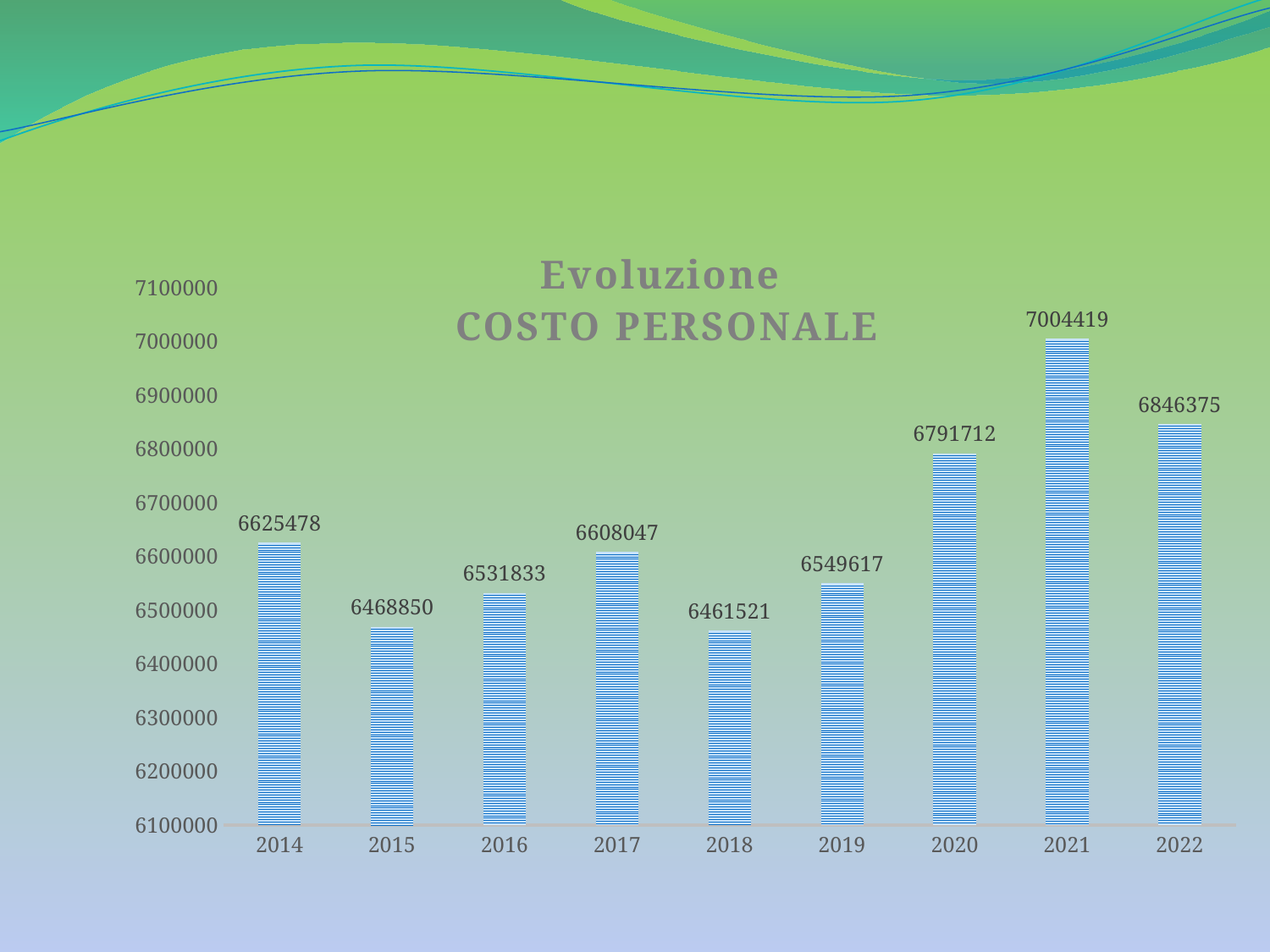
What is the title of the chart on the slide? Evoluzione COSTO PERSONALE What is the value for 2014 in the Evoluzione COSTO PERSONALE chart? 6625478 Which year has the lowest value in the Evoluzione COSTO PERSONALE chart? 2018 How many years are shown in the Evoluzione COSTO PERSONALE chart? 9 What is the value for 2018 in the Evoluzione COSTO PERSONALE chart? 6461521 Is the value for 2020 in the Evoluzione COSTO PERSONALE chart greater or less than 6700000? greater Which year has the highest value in the Evoluzione COSTO PERSONALE chart? 2021 What kind of chart is the Evoluzione COSTO PERSONALE chart? bar chart Which is larger in the Evoluzione COSTO PERSONALE chart, the value for 2020 or the value for 2022? 2022 What is the difference between the values for 2022 and 2014 in the Evoluzione COSTO PERSONALE chart? 220897 What is the difference between the values for 2021 and 2020 in the Evoluzione COSTO PERSONALE chart? 212707 What is the value for 2021 in the Evoluzione COSTO PERSONALE chart? 7004419